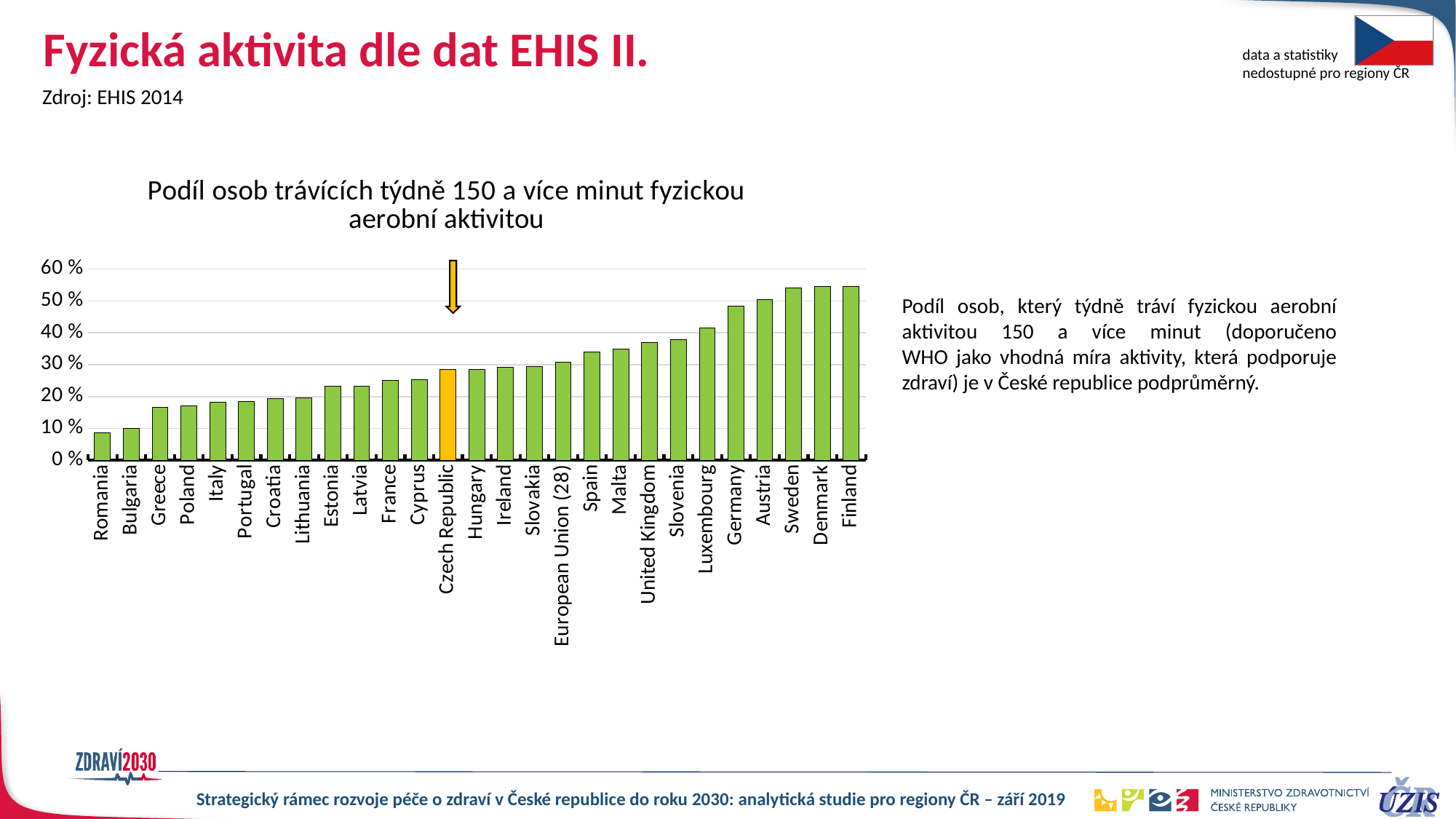
Which category has the lowest value in the chart? Romania Is the value for Romania greater or less than 10 %? less Which has a larger value, Germany or Spain? Germany Do the values rise or fall moving from left to right along the x axis? rise Is the value for Finland greater or less than 50 %? greater Which category's bar is highlighted in a different colour (orange) from the others? Czech Republic Which has a larger value, Czech Republic or Poland? Czech Republic What kind of chart is shown on the slide? bar chart Is the value for Greece greater or less than 20 %? less How many countries/categories are plotted on the x axis of the chart? 27